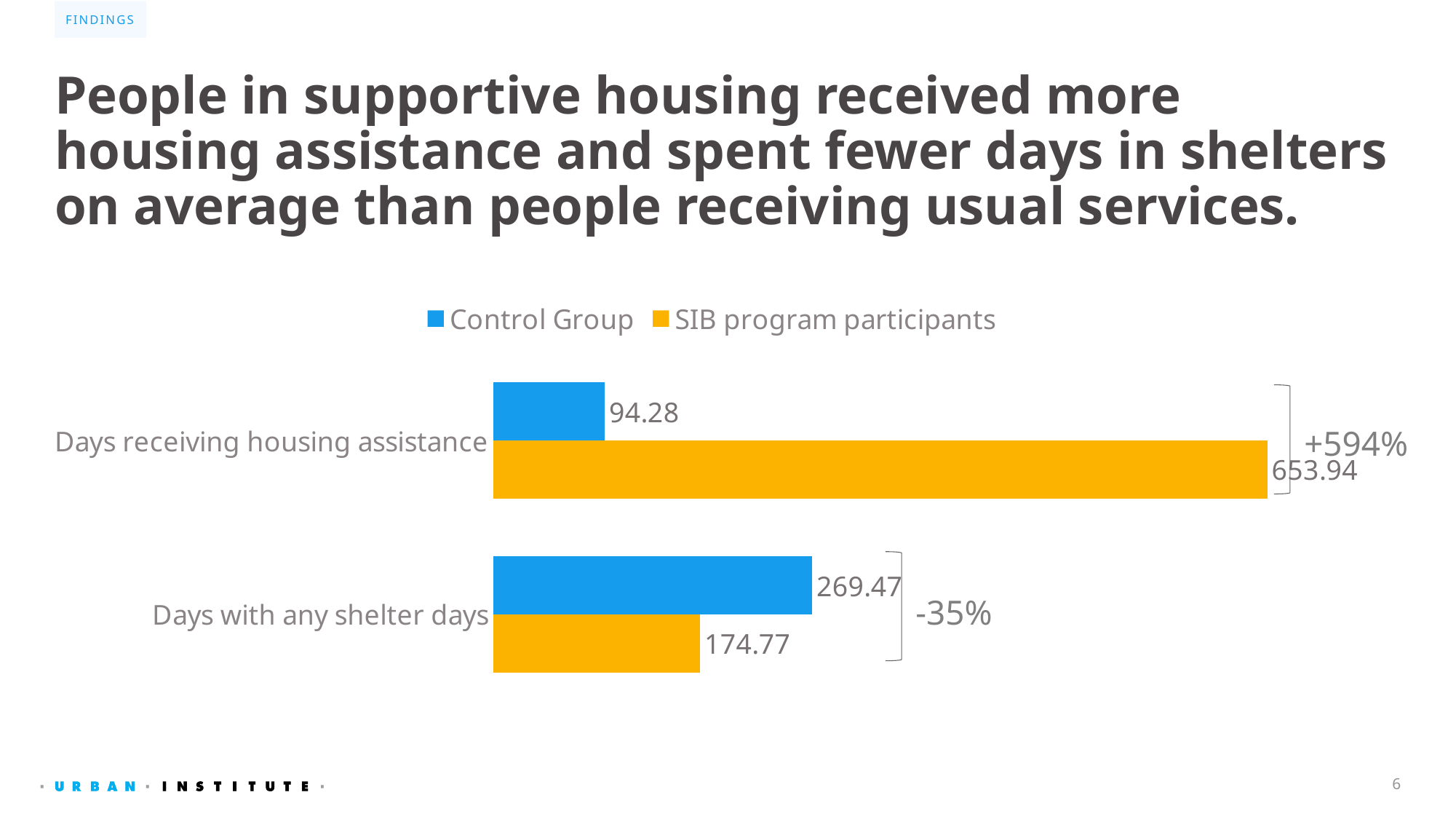
For Days receiving housing assistance, which series has the larger value: Control Group or SIB program participants? SIB program participants How many series does the legend list? 2 What kind of chart is shown on the slide? Bar chart What is the value for SIB program participants for Days with any shelter days? 174.77 How many categories are shown in the chart? 2 Which category has the highest value for SIB program participants? Days receiving housing assistance What percentage change is annotated next to the Days with any shelter days bars? -35% What is the difference between SIB program participants and the Control Group for Days with any shelter days? 94.70 What is the value for the Control Group for Days receiving housing assistance? 94.28 What is the value for the Control Group for Days with any shelter days? 269.47 Which category has the lowest value for the Control Group? Days receiving housing assistance What is the value for SIB program participants for Days receiving housing assistance? 653.94